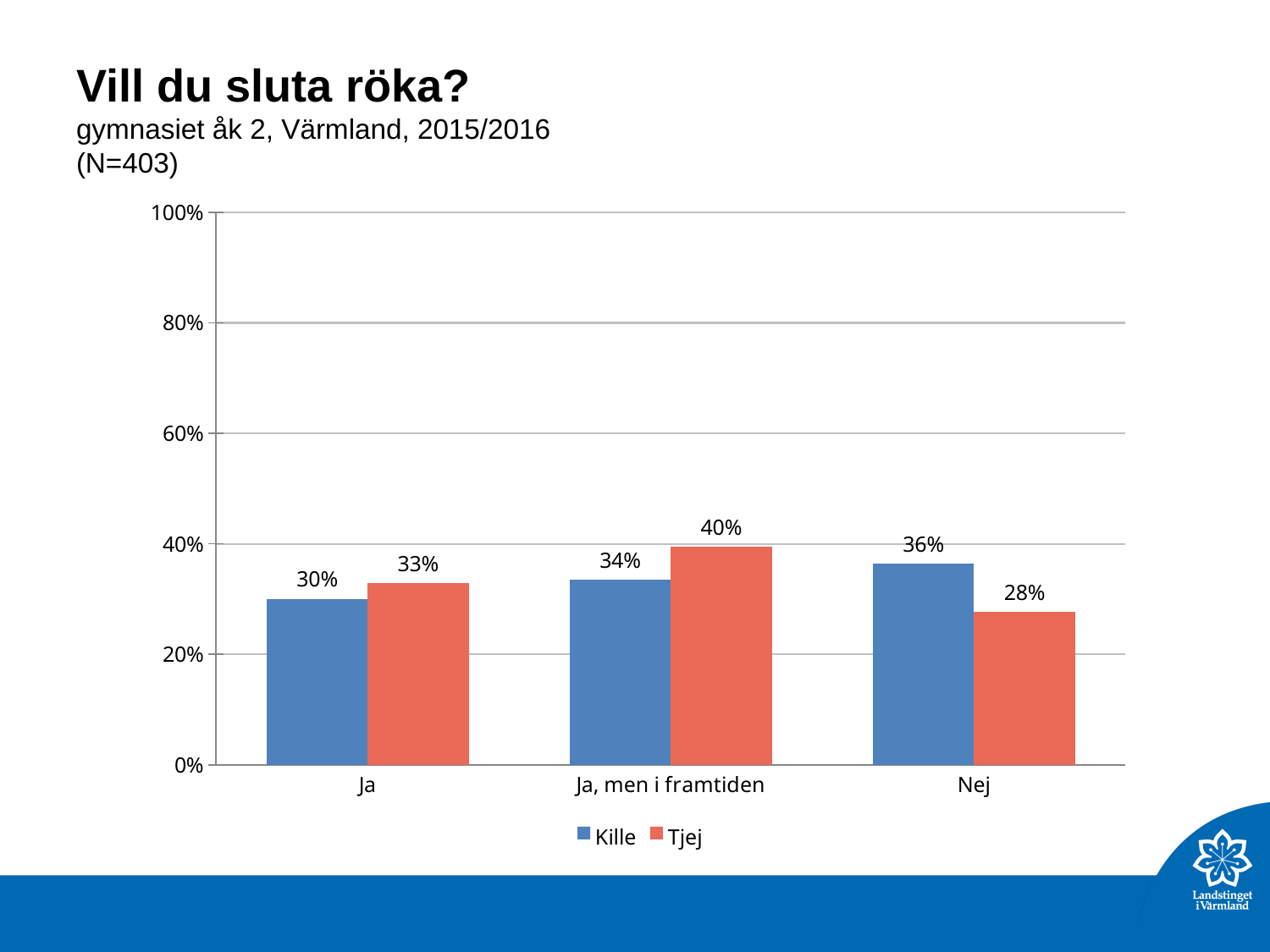
Is the value for Tjej in the 'Ja, men i framtiden' category greater or less than 20%? greater What is the difference between Tjej and Kille in the 'Ja, men i framtiden' category? 6% What is the value for Tjej in the 'Nej' category? 28% What is the value for Kille in the 'Ja' category? 30% What kind of chart is shown on the slide? bar chart What is the value for Tjej in the 'Ja, men i framtiden' category? 40% How many series does the legend list? 2 Which category has the highest value for Kille? Nej In the 'Nej' category, which series has the larger value, Kille or Tjej? Kille What is the title of the slide? Vill du sluta röka? How many categories are shown on the x axis? 3 Which category has the lowest value for Tjej? Nej